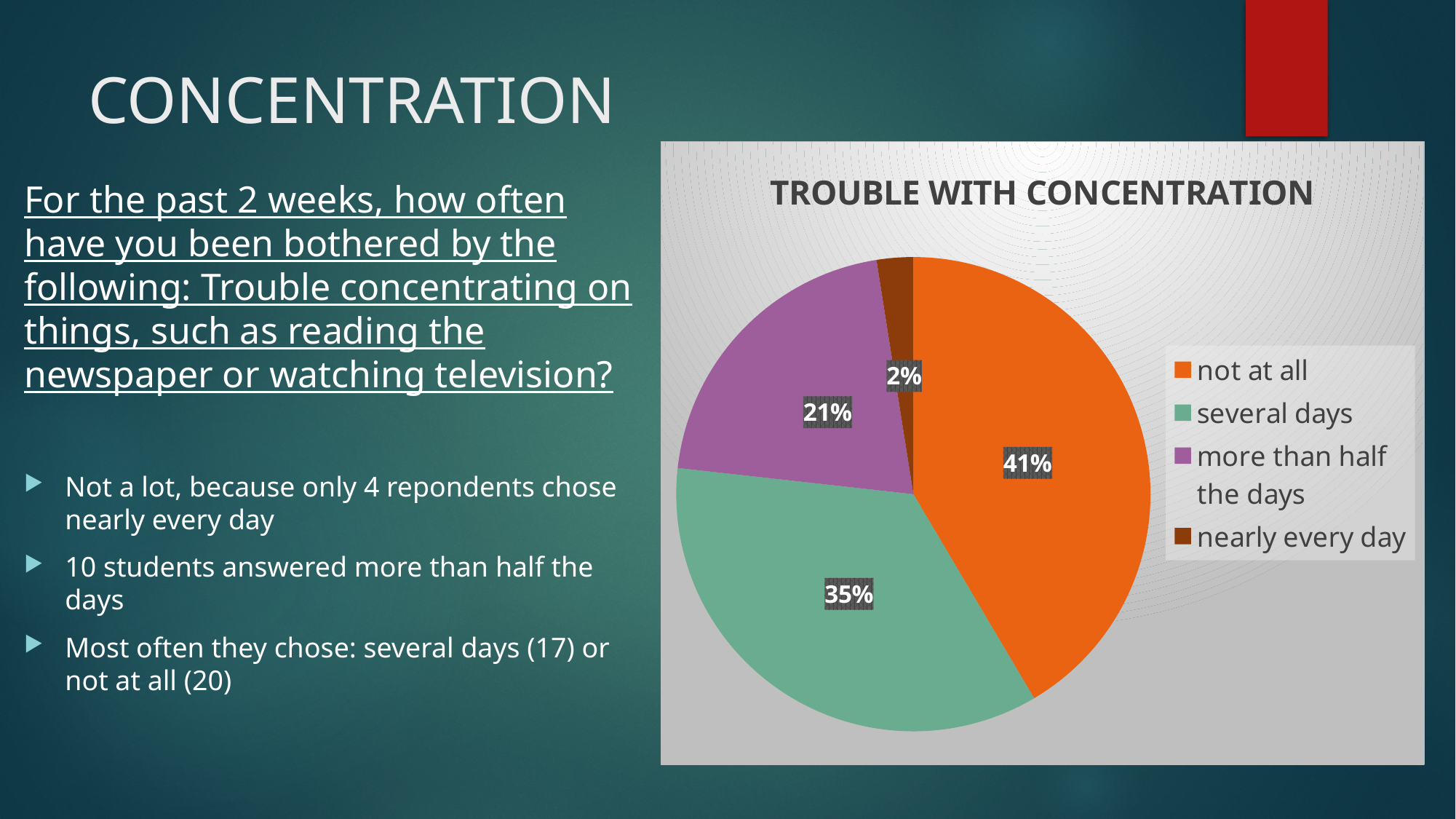
Which category has the smallest share of the pie? nearly every day What percentage of the pie is 'not at all'? 41% What colour is the 'more than half the days' slice? purple What type of chart is shown on the slide? pie chart What is the title of the chart? TROUBLE WITH CONCENTRATION What percentage of the pie is 'several days'? 35% What percentage of the pie is 'nearly every day'? 2% What percentage of the pie is 'more than half the days'? 21% What is the difference in percentage points between 'not at all' and 'several days'? 6 How many categories does the legend list? 4 Which is larger: 'several days' or 'more than half the days'? several days Which category has the largest share of the pie? not at all